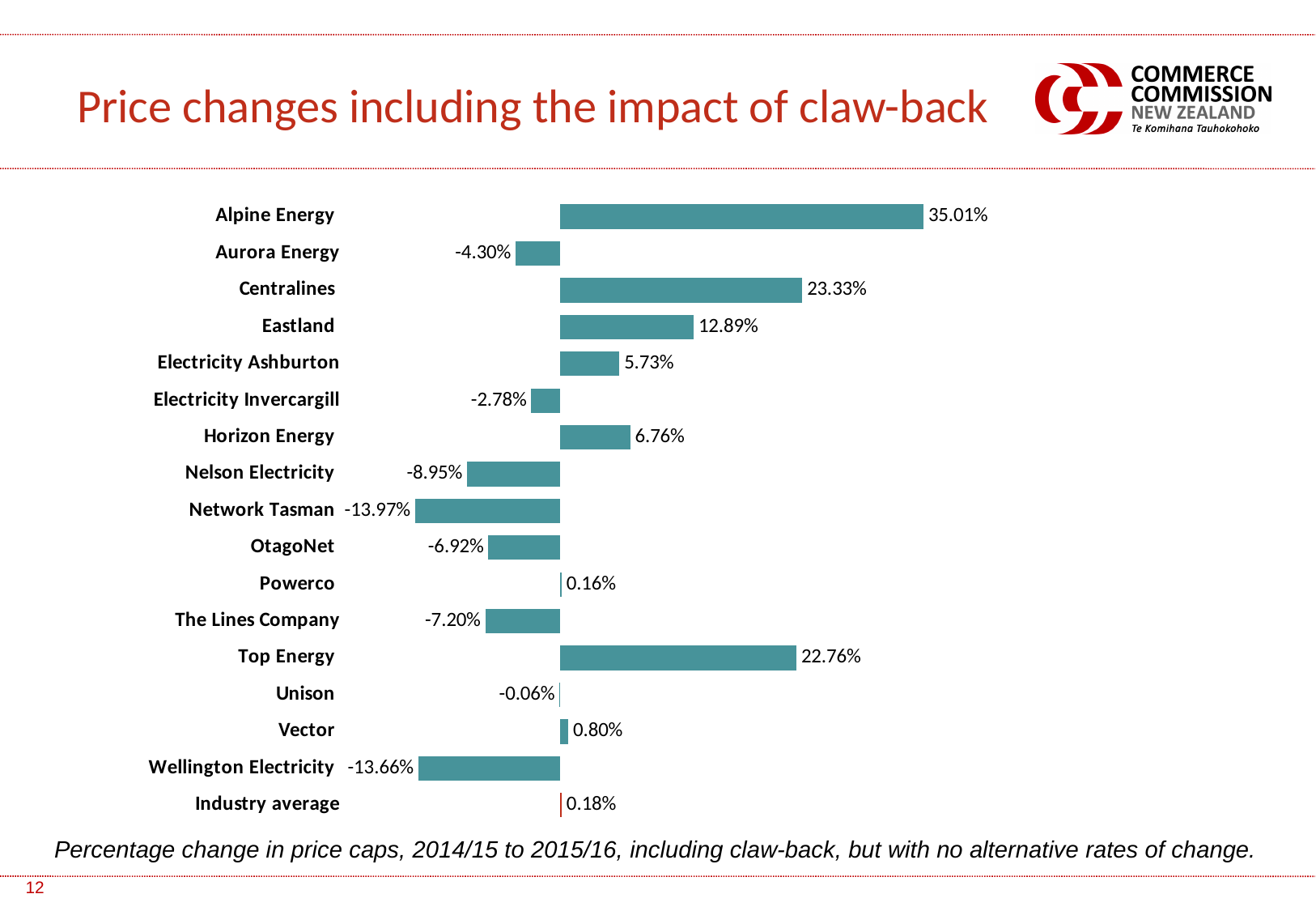
Which company has the highest price change? Alpine Energy How many bars (categories) are shown in the chart? 17 What kind of chart is shown on the slide? Bar chart What is the value shown for the Industry average? 0.18% What is the title of the slide containing the chart? Price changes including the impact of claw-back Which is larger, the value for Centralines or the value for Top Energy? Centralines What is the value for Alpine Energy? 35.01% What is the value for Network Tasman? -13.97% What is the difference between the values for Alpine Energy and Centralines? 11.68 percentage points Which company has the lowest price change? Network Tasman What is the difference between the values for Eastland and Electricity Ashburton? 7.16 percentage points What is the value for Wellington Electricity? -13.66%